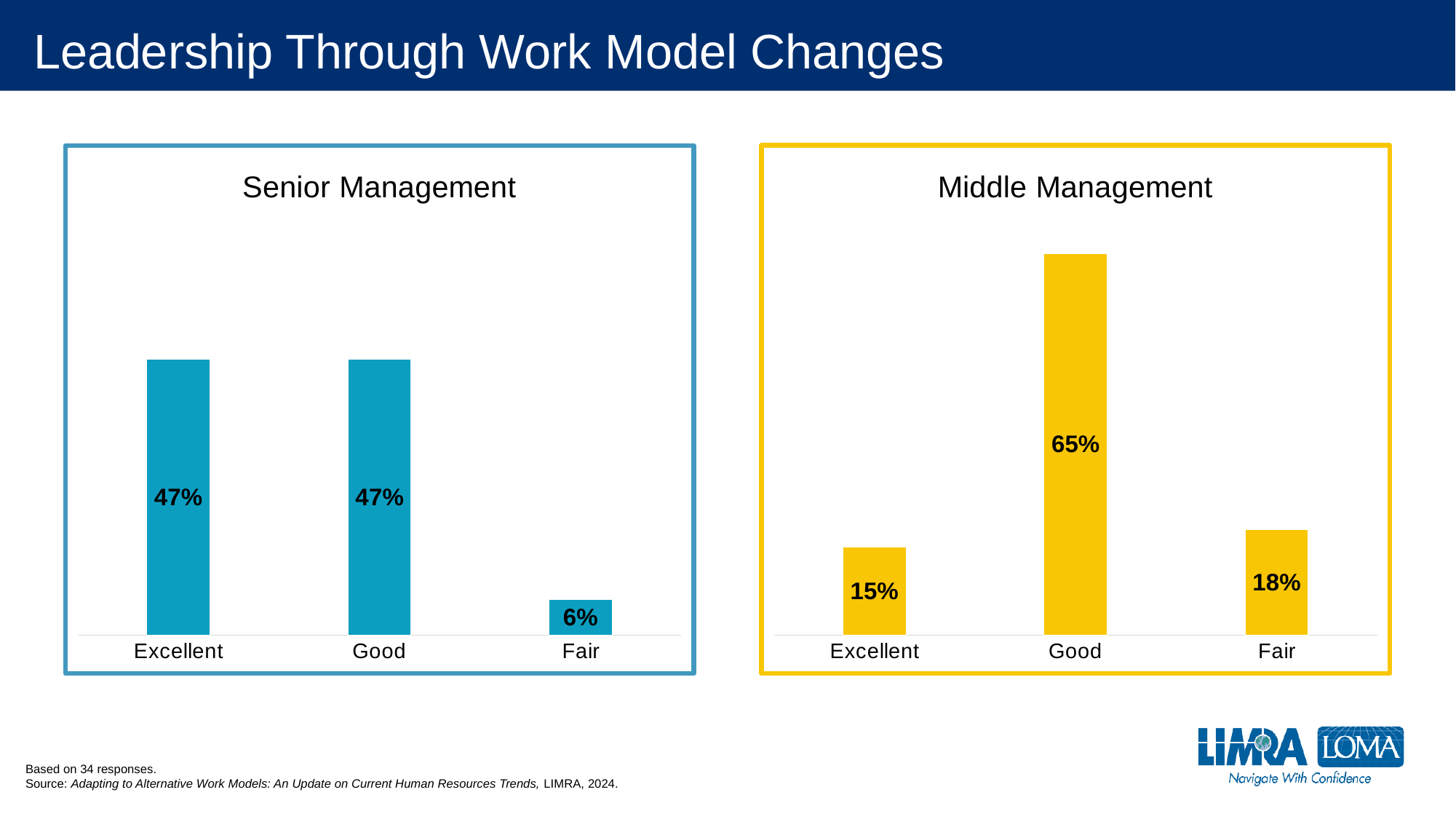
In the Middle Management chart, what is the difference between the values for Good and Fair? 47% Which is larger: the value for Good in the Senior Management chart or the value for Good in the Middle Management chart? Middle Management In the Middle Management chart, what is the value for Good? 65% How many categories are shown in the Senior Management chart? 3 In the Middle Management chart, which category has the highest value? Good In the Senior Management chart, what is the value for Excellent? 47% In the Middle Management chart, what is the value for Excellent? 15% In the Senior Management chart, what is the value for Fair? 6% In the Middle Management chart, what is the value for Fair? 18% In the Senior Management chart, which category has the lowest value? Fair In the Middle Management chart, which category has the lowest value? Excellent In the Senior Management chart, what is the difference between the values for Good and Fair? 41%